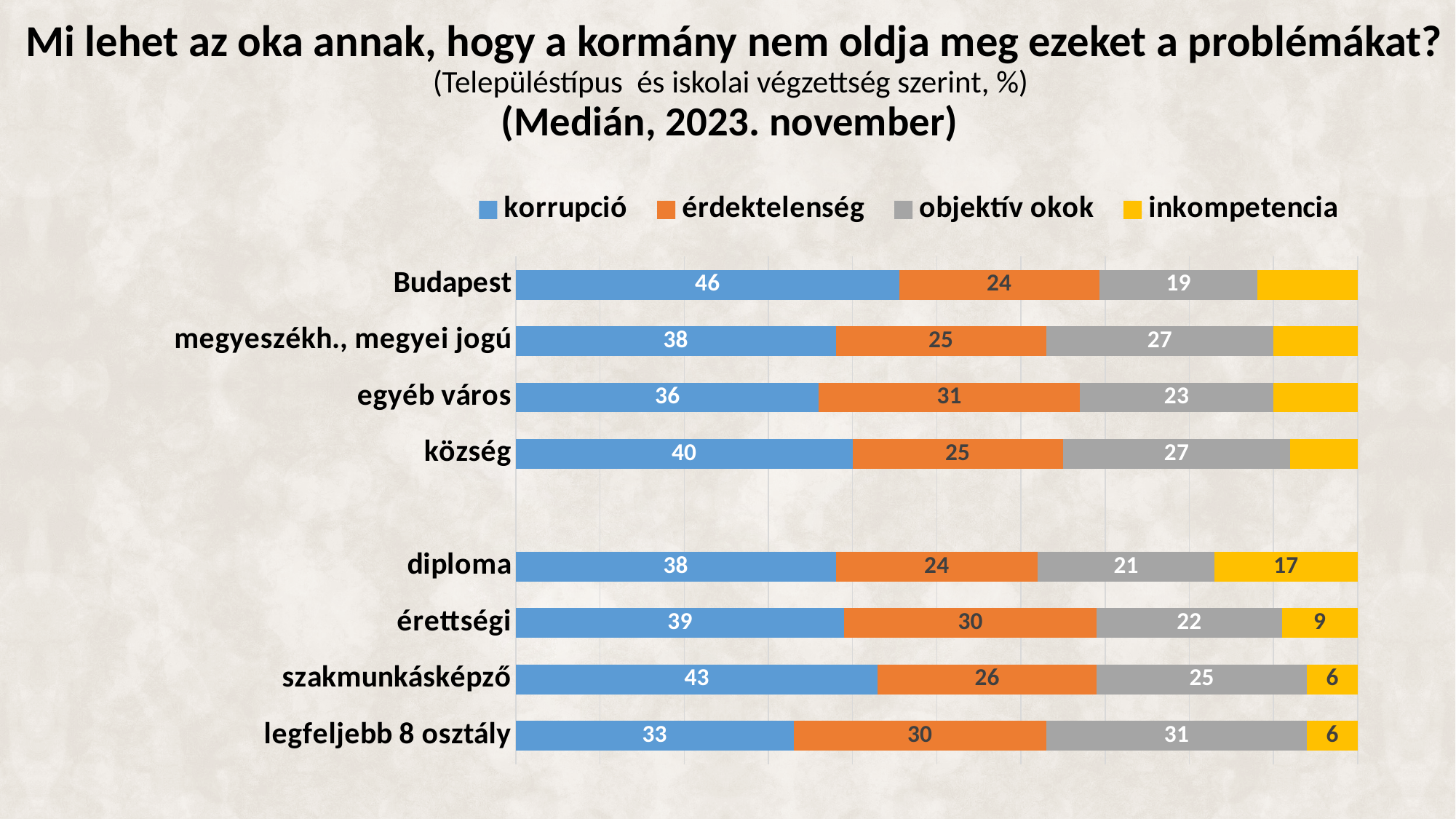
What is the inkompetencia value for diploma? 17 Which category has the lowest korrupció value? legfeljebb 8 osztály Which category has the highest korrupció value? Budapest What is the érdektelenség value for egyéb város? 31 What is the korrupció value for Budapest? 46 Which is larger, the inkompetencia value for érettségi or for szakmunkásképző? érettségi What is the difference between the korrupció values for Budapest and legfeljebb 8 osztály? 13 How many categories are shown on the chart? 8 What kind of chart is shown on the slide? stacked bar chart How many series does the legend list? 4 What is the total of the stacked bar for diploma? 100 What is the objektív okok value for legfeljebb 8 osztály? 31